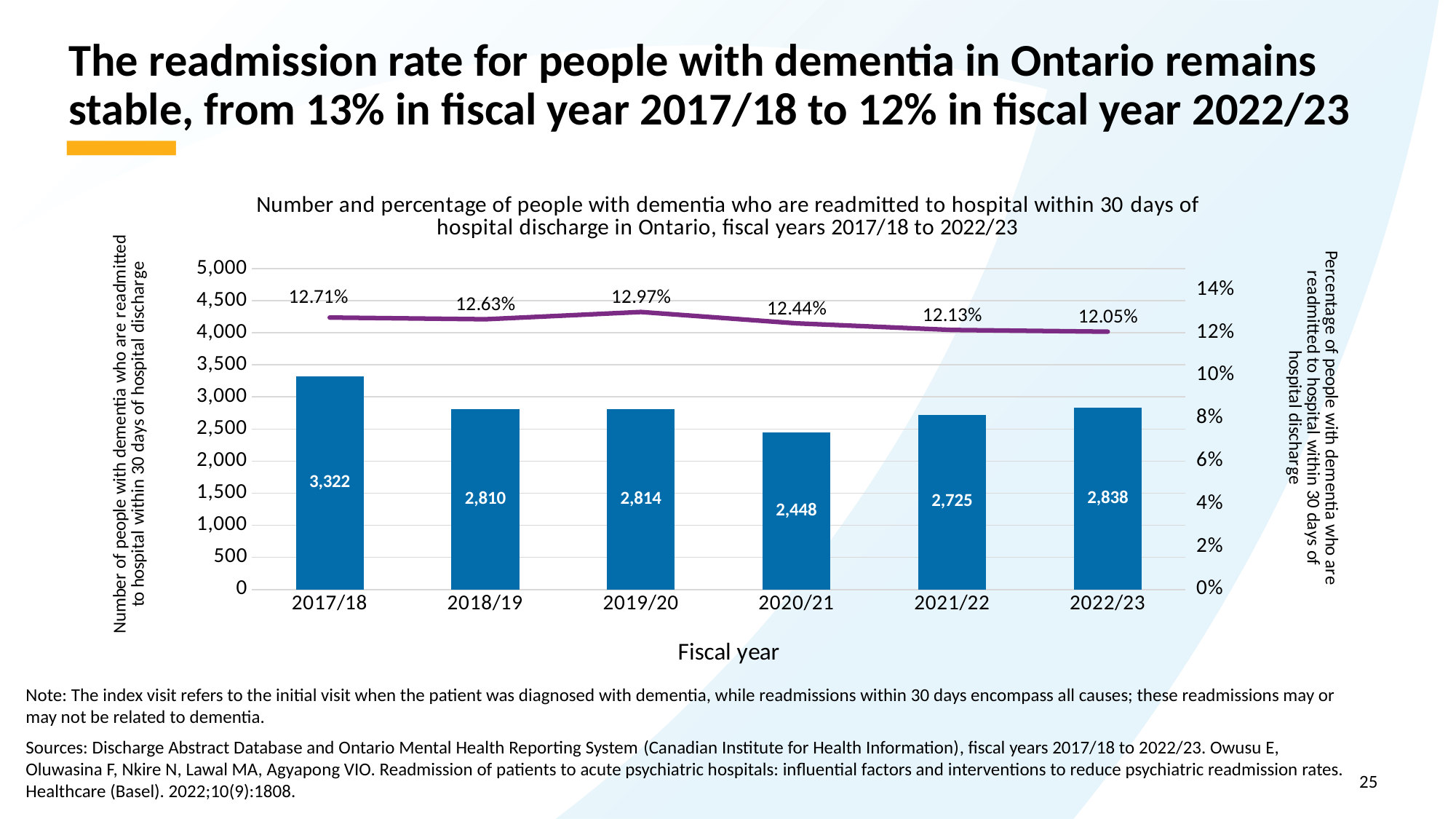
Which fiscal year had the highest number of readmissions? 2017/18 Did the readmission percentage rise or fall from fiscal year 2019/20 to 2022/23? fall How many people with dementia were readmitted to hospital within 30 days of discharge in fiscal year 2017/18? 3,322 What is the difference in the number of readmissions between fiscal years 2017/18 and 2022/23? 484 What is the label of the x axis? Fiscal year Is the number of readmissions in fiscal year 2020/21 greater or less than 2,500? less Which fiscal year had the lowest readmission percentage? 2022/23 What was the number of readmissions in fiscal year 2020/21? 2,448 What was the readmission percentage for people with dementia in fiscal year 2019/20? 12.97% How many fiscal years are shown on the x axis? 6 What kind of chart is shown on the slide? Combined bar and line chart Which fiscal year had more readmissions, 2018/19 or 2021/22? 2018/19